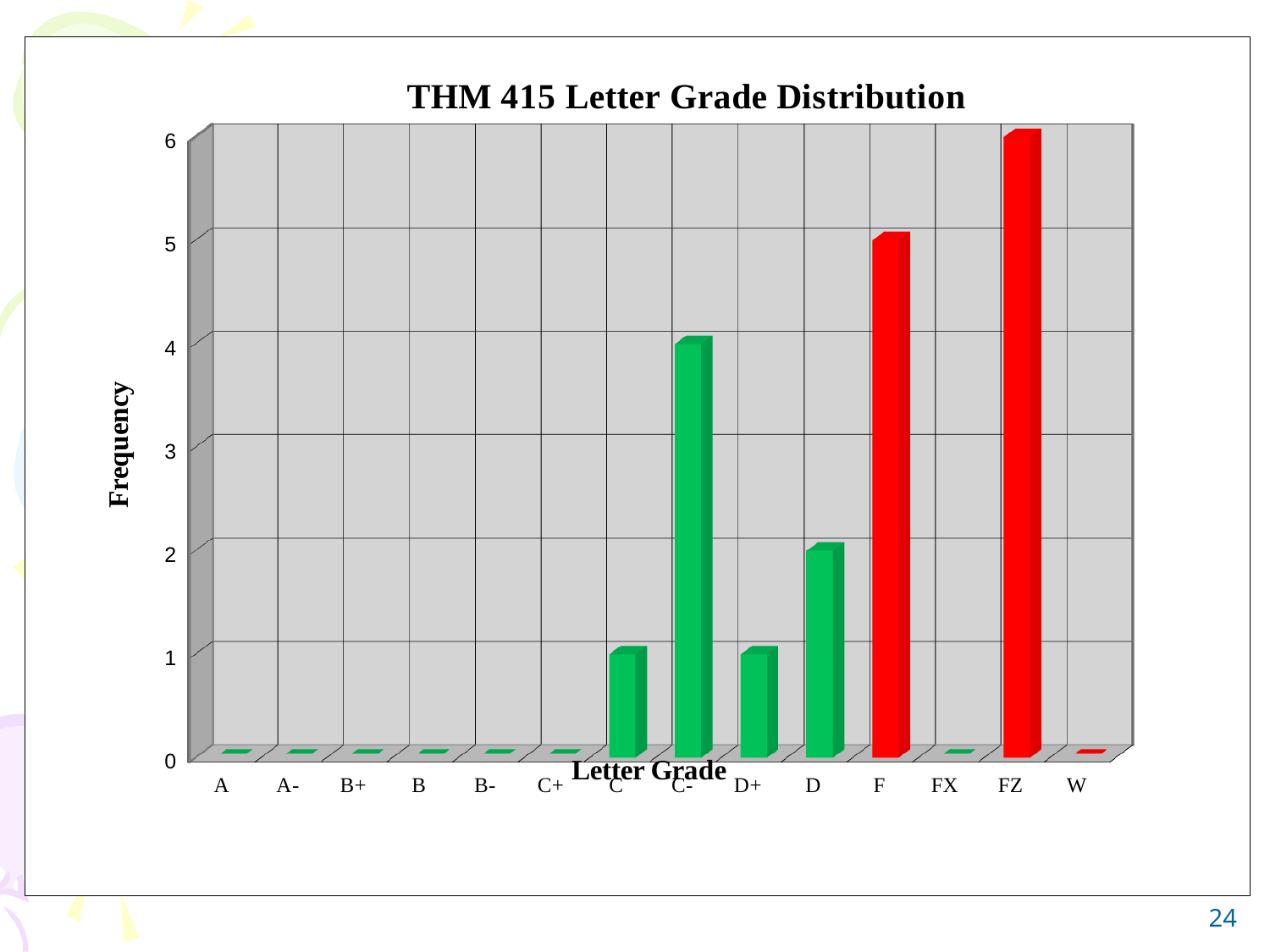
Which has a higher frequency, C- or D? C- What colour are the bars for the F and FZ grades? red Which letter grade has the highest frequency? FZ What is the difference in frequency between FZ and F? 1 What type of chart is shown on the slide? bar chart What is the frequency for the C grade? 1 How many letter grade categories are shown on the x axis? 14 What is the frequency for the F grade? 5 What is the frequency for the C- grade? 4 What is the title of the chart? THM 415 Letter Grade Distribution What is the frequency for the D grade? 2 What is the frequency for the FZ grade? 6